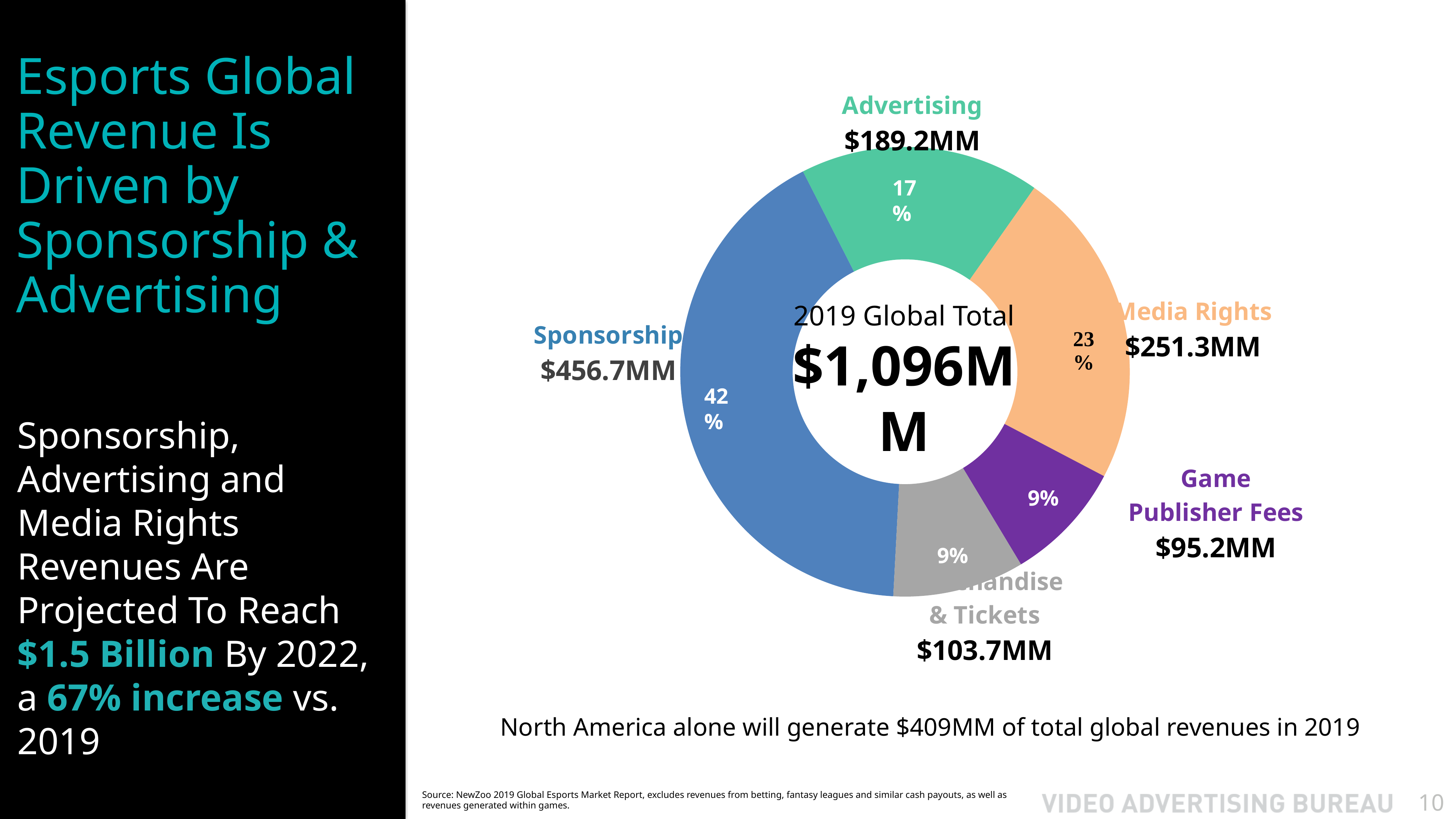
What is the revenue value shown for Sponsorship? $456.7MM Which revenue category is the largest in the chart? Sponsorship What is the revenue value shown for Game Publisher Fees? $95.2MM What is the revenue value shown for Media Rights? $251.3MM What percentage share of the donut does Media Rights represent? 23% Which is larger in revenue, Advertising or Media Rights? Media Rights How many revenue categories are shown in the donut chart? 5 What is the revenue value shown for Advertising? $189.2MM What is the 2019 Global Total shown in the center of the chart? $1,096MM What percentage share of the donut does Sponsorship represent? 42% Which revenue category has the smallest dollar value in the chart? Game Publisher Fees What is the difference in revenue between Sponsorship and Media Rights? $205.4MM